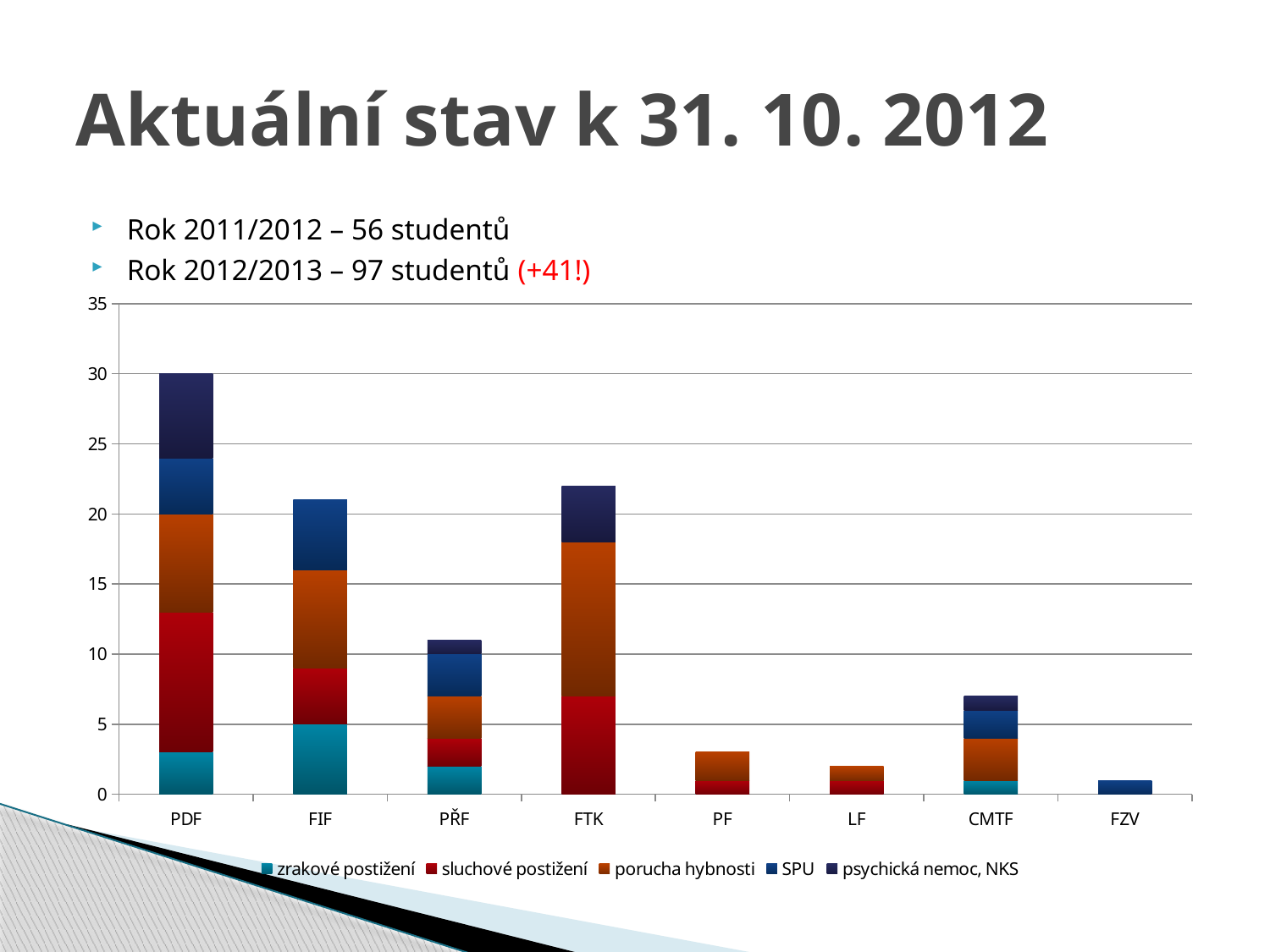
Is the total value for PF greater or less than 5? less How many faculties (categories) are shown on the x axis of the chart? 8 Is the total value for PŘF greater or less than 15? less Is the total value for CMTF greater or less than 5? greater Which stacked bar is taller, PDF or FTK? PDF Which faculty has the tallest stacked bar in the chart? PDF What kind of chart is shown on the slide? stacked bar chart Which series is listed first in the chart's legend? zrakové postižení What is the total height of the stacked bar for PDF? 30 How many series does the chart's legend list? 5 Which faculty has the shortest stacked bar in the chart? FZV